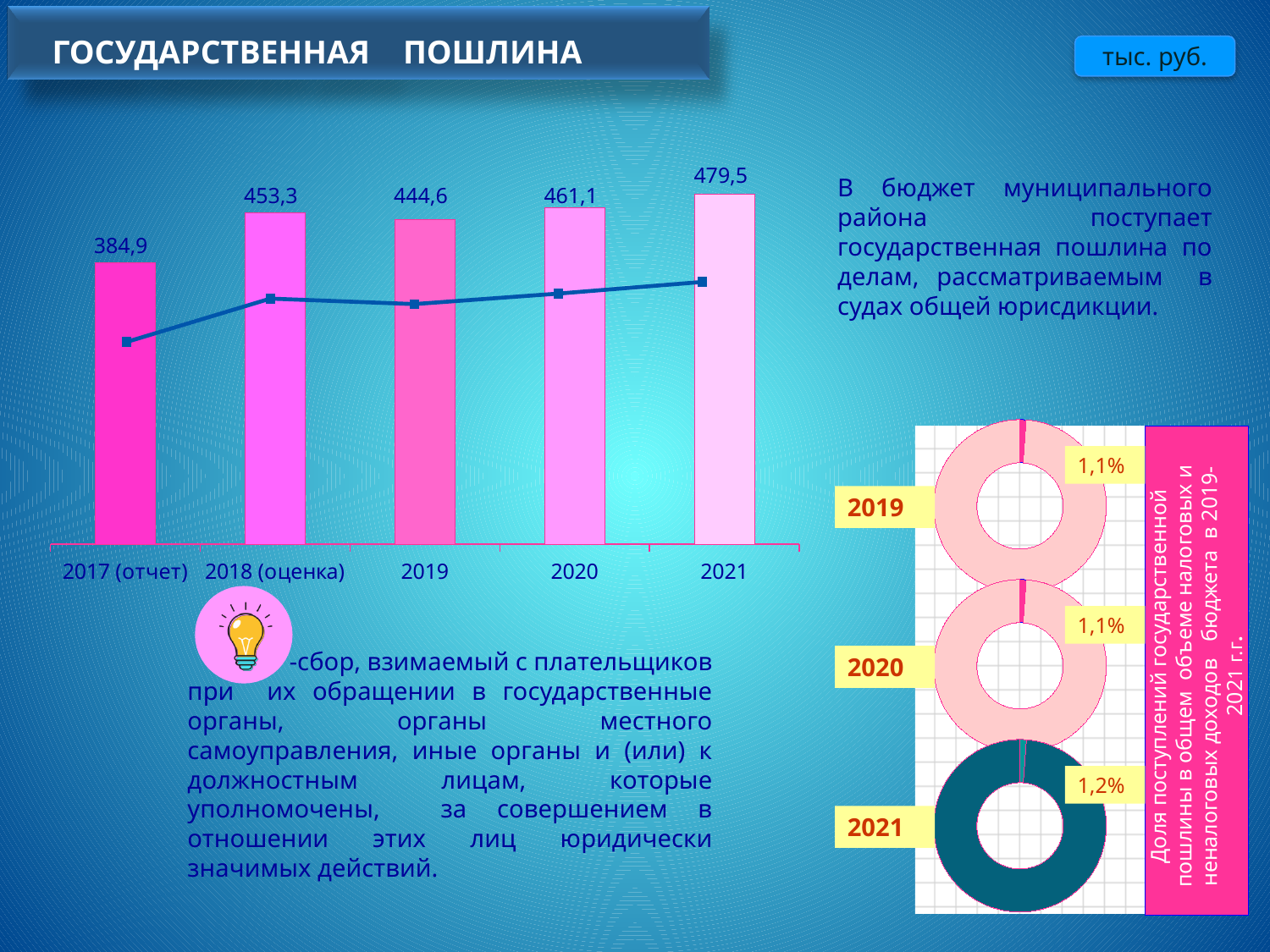
On the bar chart, what is the value for 2019? 444,6 On the bar chart, which category has the lowest value? 2017 (отчет) On the bar chart, what is the difference between the values for 2021 and 2017 (отчет)? 94,6 On the bar chart, what is the difference between the values for 2020 and 2019? 16,5 On the donut charts on the right, what share is shown for 2021? 1,2% What type of chart is the large chart on the left of the slide? Bar chart with a line overlay How many categories are shown on the bar chart? 5 On the bar chart, what is the value for 2021? 479,5 On the bar chart, which year has the highest value? 2021 On the bar chart, what is the value for 2017 (отчет)? 384,9 On the bar chart, which is larger: the value for 2018 (оценка) or the value for 2019? 2018 (оценка) On the donut charts on the right, what share is shown for 2019? 1,1%